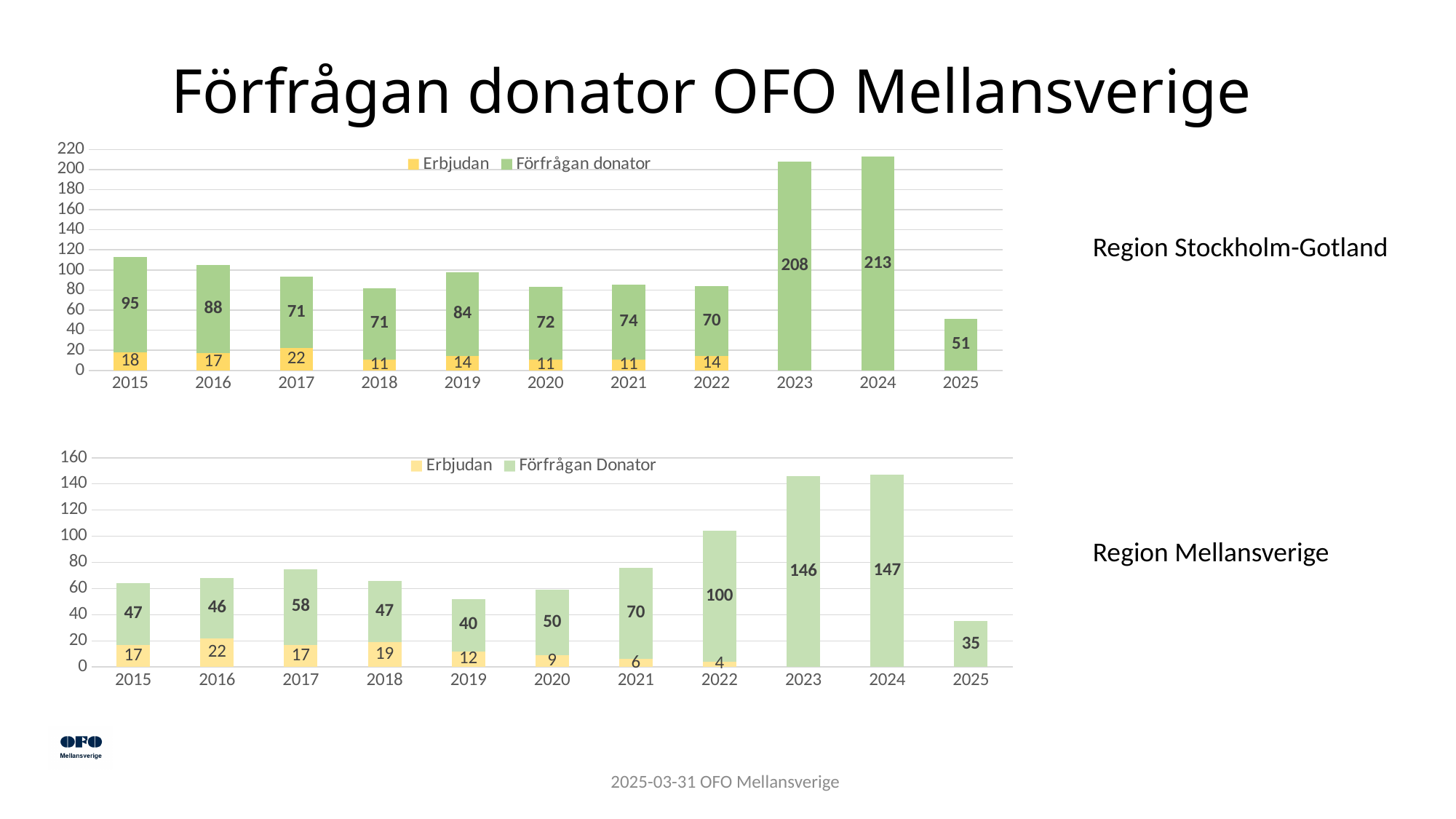
In the Region Mellansverige chart, which is larger: the Förfrågan Donator value for 2017 or for 2020? 2017 In the Region Mellansverige chart, what is the Erbjudan value for 2021? 6 In the Region Stockholm-Gotland chart, what is the Erbjudan value for 2017? 22 In the Region Stockholm-Gotland chart, what is the difference between the Förfrågan donator values for 2024 and 2023? 5 How many series does the legend of the Region Stockholm-Gotland chart list? 2 In the Region Mellansverige chart, what is the total of the stacked bar for 2022? 104 In the Region Stockholm-Gotland chart, which year has the highest Förfrågan donator value? 2024 In the Region Stockholm-Gotland chart, what is the Förfrågan donator value for 2024? 213 In the Region Mellansverige chart, what is the Förfrågan Donator value for 2022? 100 How many years are shown on the x axis of the Region Mellansverige chart? 11 In the Region Stockholm-Gotland chart, what is the total of the stacked bar for 2015? 113 In the Region Mellansverige chart, which year has the lowest Förfrågan Donator value? 2025